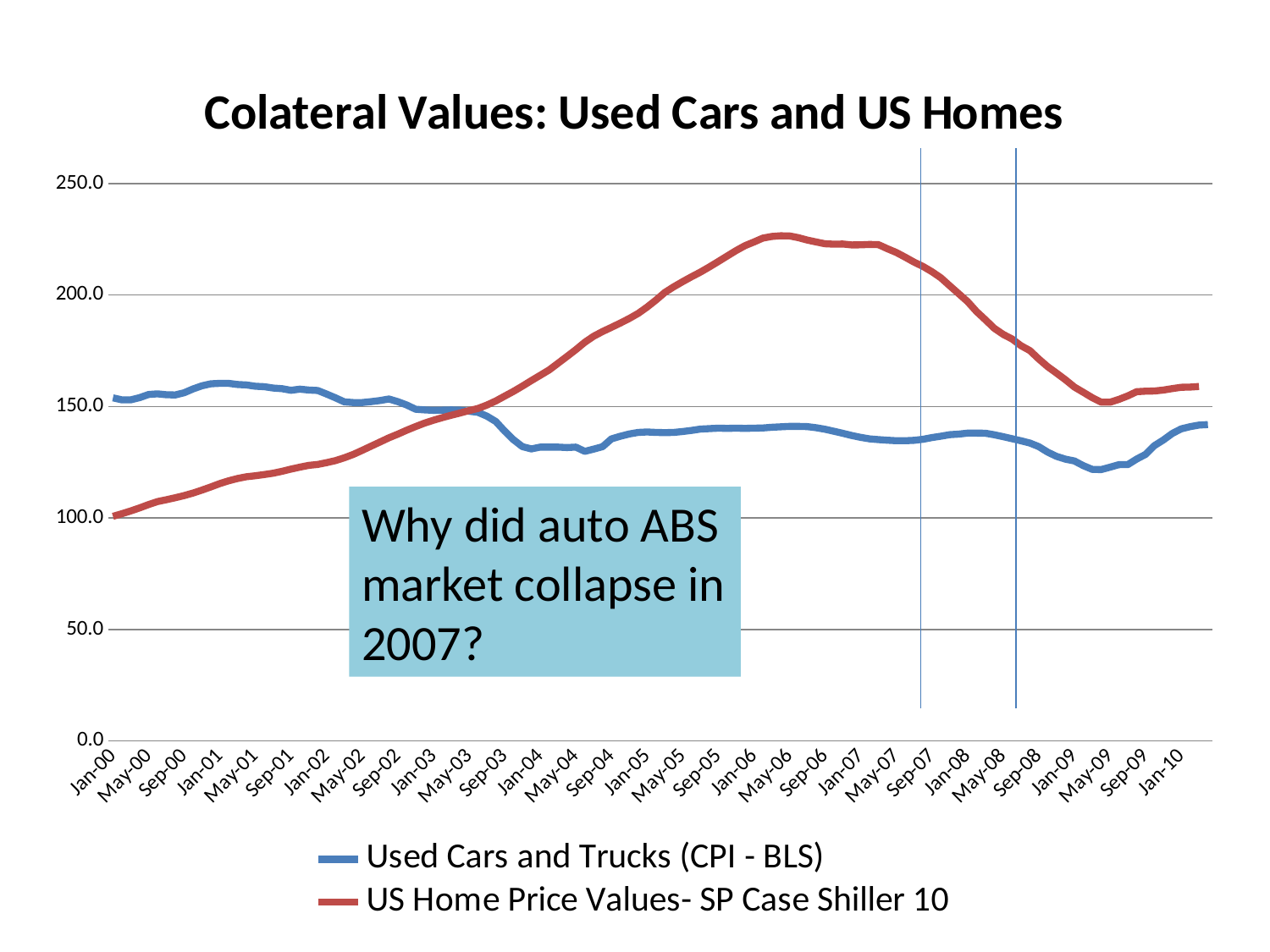
Which series is drawn in red? US Home Price Values- SP Case Shiller 10 Do the values for US Home Price Values- SP Case Shiller 10 rise or fall from May-06 to May-09? fall How many series does the legend list? 2 What is the title of the chart? Colateral Values: Used Cars and US Homes Do the values for US Home Price Values- SP Case Shiller 10 rise or fall from Jan-00 to May-06? rise Is the value for US Home Price Values- SP Case Shiller 10 at May-06 greater or less than 200? greater Is the value for Used Cars and Trucks (CPI - BLS) at May-09 greater or less than 150? less At Jan-01, which series has the higher value, Used Cars and Trucks (CPI - BLS) or US Home Price Values- SP Case Shiller 10? Used Cars and Trucks (CPI - BLS) Is the value for US Home Price Values- SP Case Shiller 10 at Jan-10 greater or less than 150? greater At Jan-07, which series has the higher value, Used Cars and Trucks (CPI - BLS) or US Home Price Values- SP Case Shiller 10? US Home Price Values- SP Case Shiller 10 What kind of chart is shown on the slide? Line chart